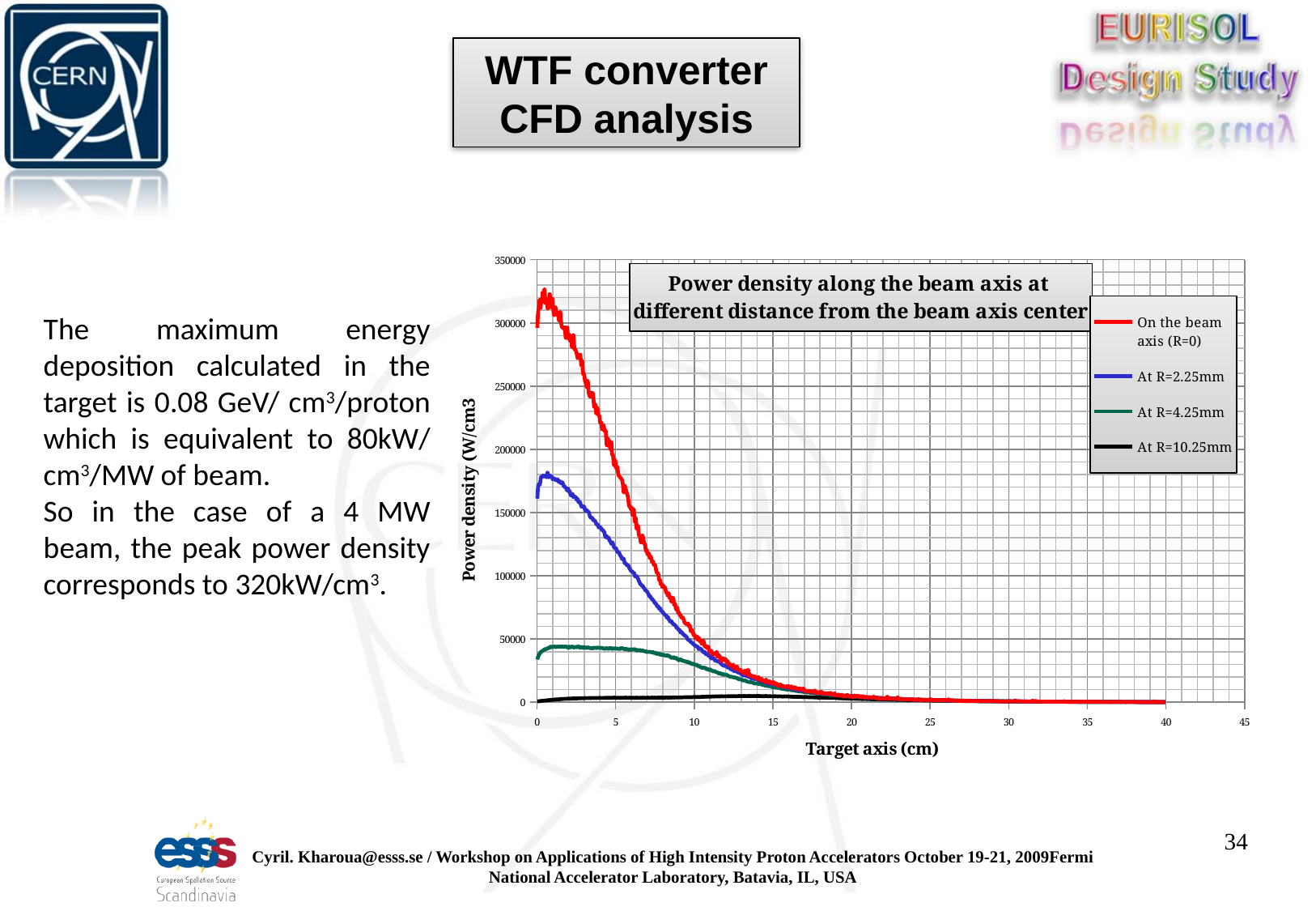
Does the power density of the 'On the beam axis (R=0)' series rise or fall along the target axis from 5 cm to 40 cm? fall What is the title of the chart? Power density along the beam axis at different distance from the beam axis center Which series has the larger peak power density, 'At R=2.25mm' or 'At R=4.25mm'? At R=2.25mm Is the peak value of the 'At R=4.25mm' series greater or less than 50000? less What kind of chart is shown on the slide? line chart How many series does the chart legend list? 4 What is the label of the x axis of the chart? Target axis (cm) Is the peak value of the 'On the beam axis (R=0)' series greater or less than 300000? greater Which series has the lowest power density across the target axis? At R=10.25mm Is the peak value of the 'At R=2.25mm' series greater or less than 200000? less Which series reaches the highest power density on the chart? On the beam axis (R=0)